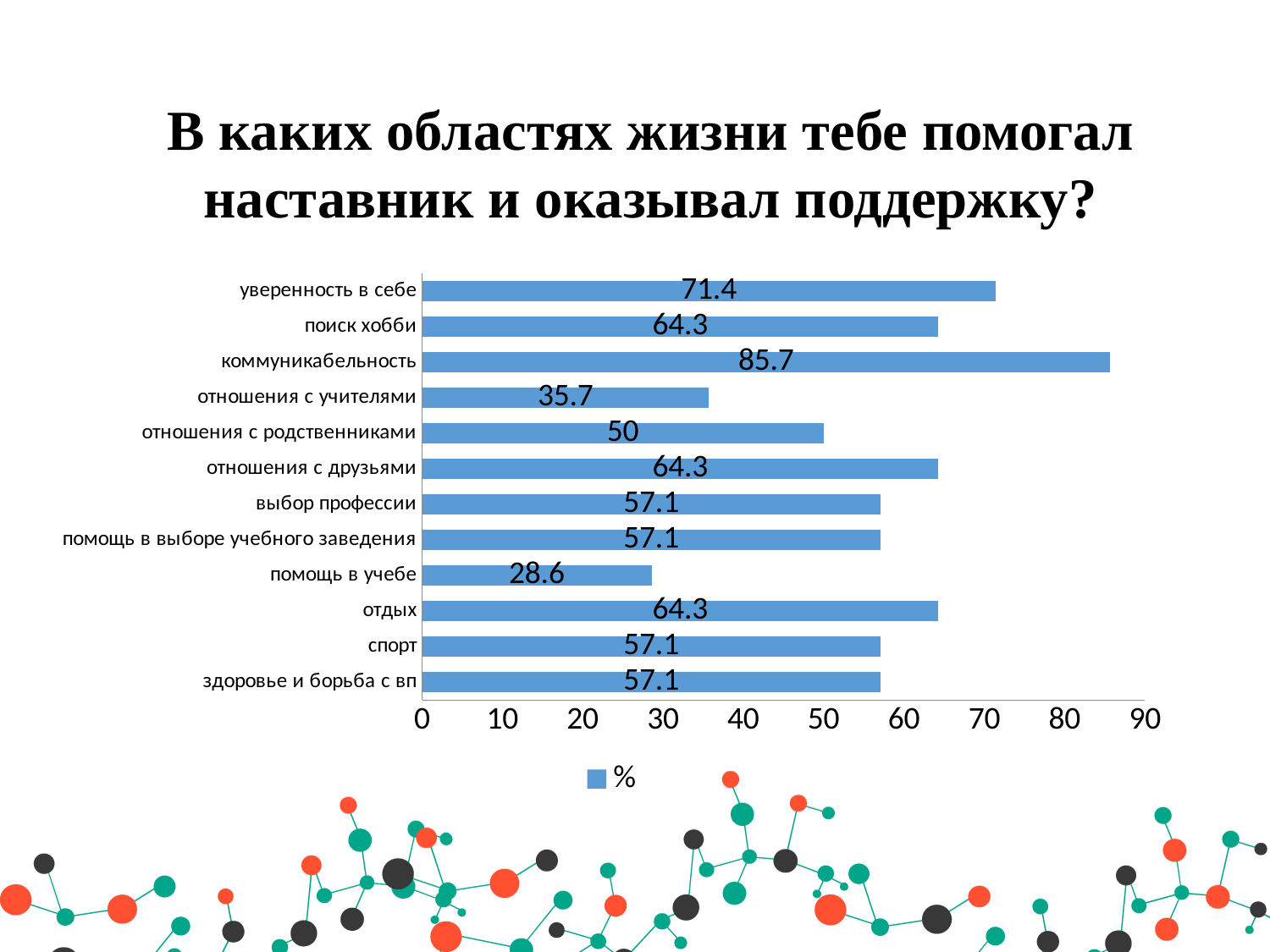
What entry does the legend show? % Which category has the highest value? коммуникабельность How many categories are shown in the chart? 12 Which is larger, the value for «уверенность в себе» or the value for «поиск хобби»? уверенность в себе What kind of chart is shown on the slide? bar chart What is the value for «отношения с учителями»? 35.7 What is the value for «коммуникабельность»? 85.7 Which category has the lowest value? помощь в учебе What is the value for «отношения с родственниками»? 50 What is the difference between the values for «коммуникабельность» and «уверенность в себе»? 14.3 Is the value for «отдых» greater or less than 60? greater What is the value for «помощь в учебе»? 28.6